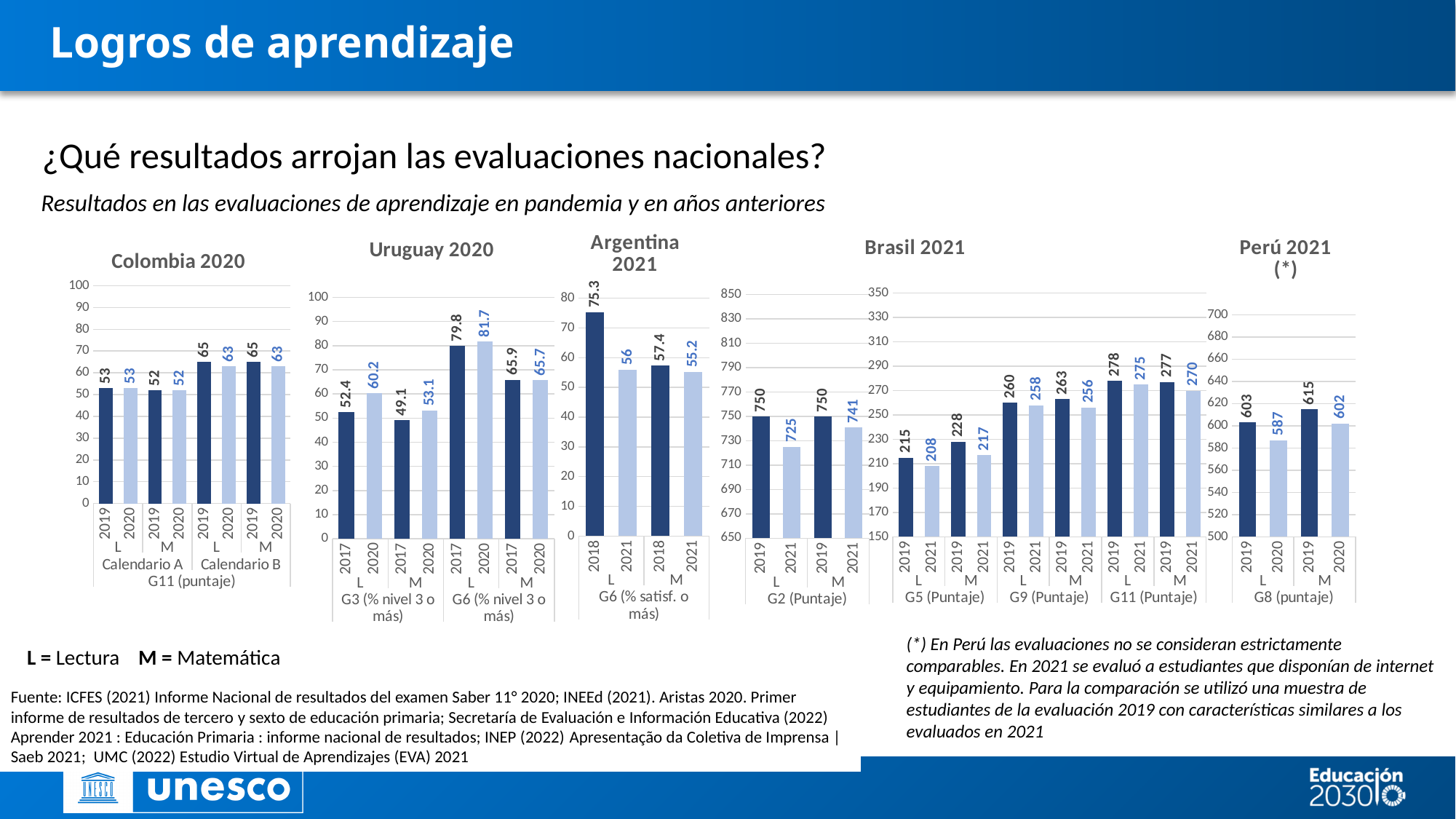
In the Argentina 2021 chart, what is the value for Lectura (L) in G6 in 2018? 75.3 In the Argentina 2021 chart, what is the difference between the Lectura (L) values for 2018 and 2021? 19.3 In the Colombia 2020 chart, which is larger for Calendario B Lectura (L): the 2019 value or the 2020 value? 2019 In the Brasil 2021 chart, what is the G2 Lectura (L) score for 2021? 725 In the Perú 2021 (*) chart, what is the G8 Matemática (M) score for 2020? 602 In the Uruguay 2020 chart, which bar has the highest value? G6 Lectura (L) 2020 In the Brasil 2021 chart, which G5 bar has the lowest score? Lectura (L) 2021 In the Uruguay 2020 chart, what is the value for Lectura (L) in G6 in 2020? 81.7 In the Uruguay 2020 chart, what is the value for Matemática (M) in G3 in 2017? 49.1 What kind of chart is the Colombia 2020 chart? Bar chart In the Brasil 2021 chart, what is the difference between the G2 Lectura (L) scores for 2019 and 2021? 25 In the Perú 2021 (*) chart, what is the difference between the G8 Lectura (L) scores for 2019 and 2020? 16